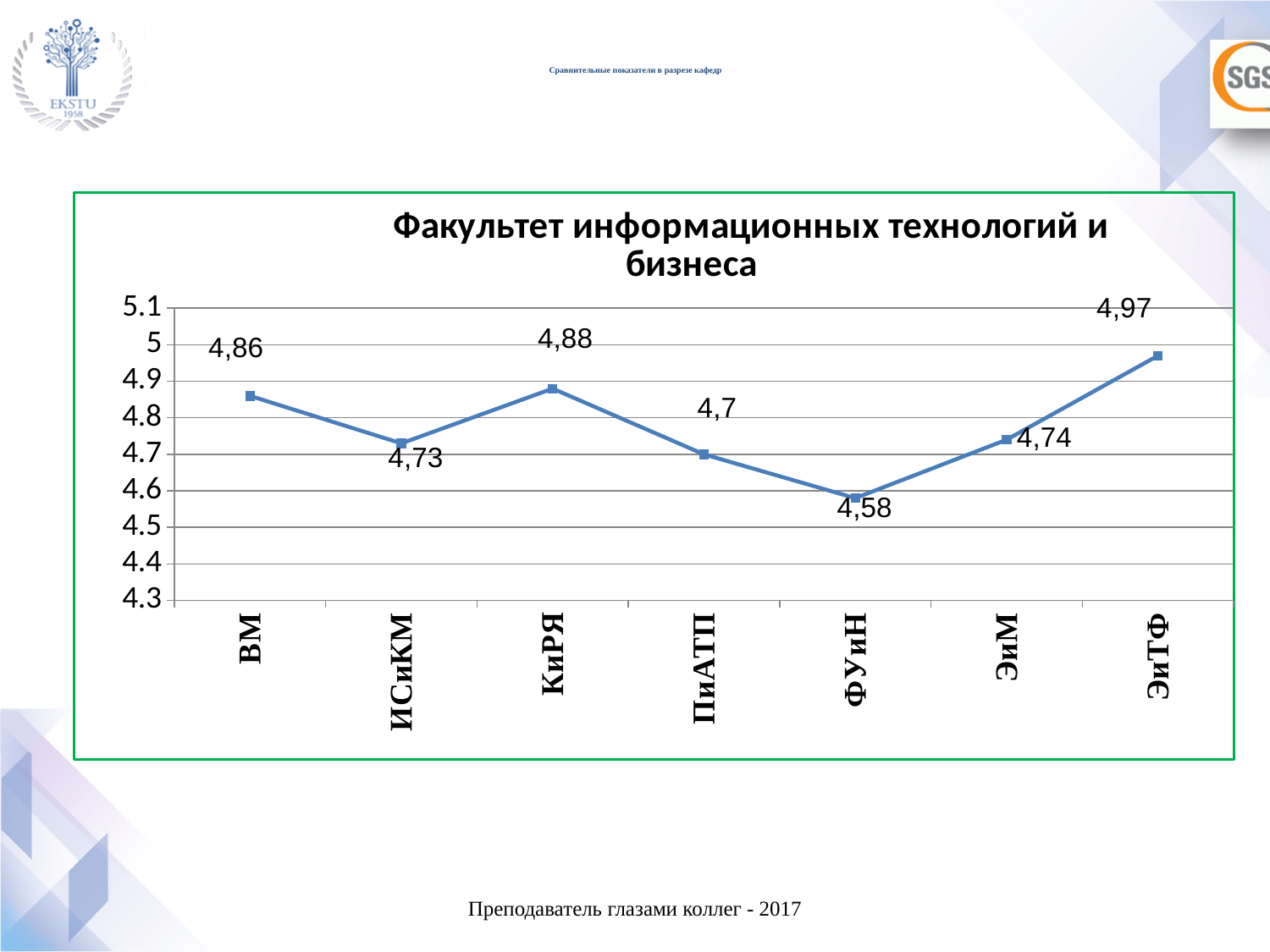
What is the value for ФУиН? 4,58 Is the value for ЭиМ greater or less than 4.8? less Which has a larger value, КиРЯ or ИСиКМ? КиРЯ What is the difference between the values for ЭиГиС and ФУиН? 0,39 Which department has the highest value? ЭиГиС Which department has the lowest value? ФУиН What is the value for ВМ? 4,86 What kind of chart is shown? line chart What is the value for ПиАТП? 4,7 What is the title of the chart? Факультет информационных технологий и бизнеса How many departments are plotted on the chart? 7 What is the value for ЭиГиС? 4,97